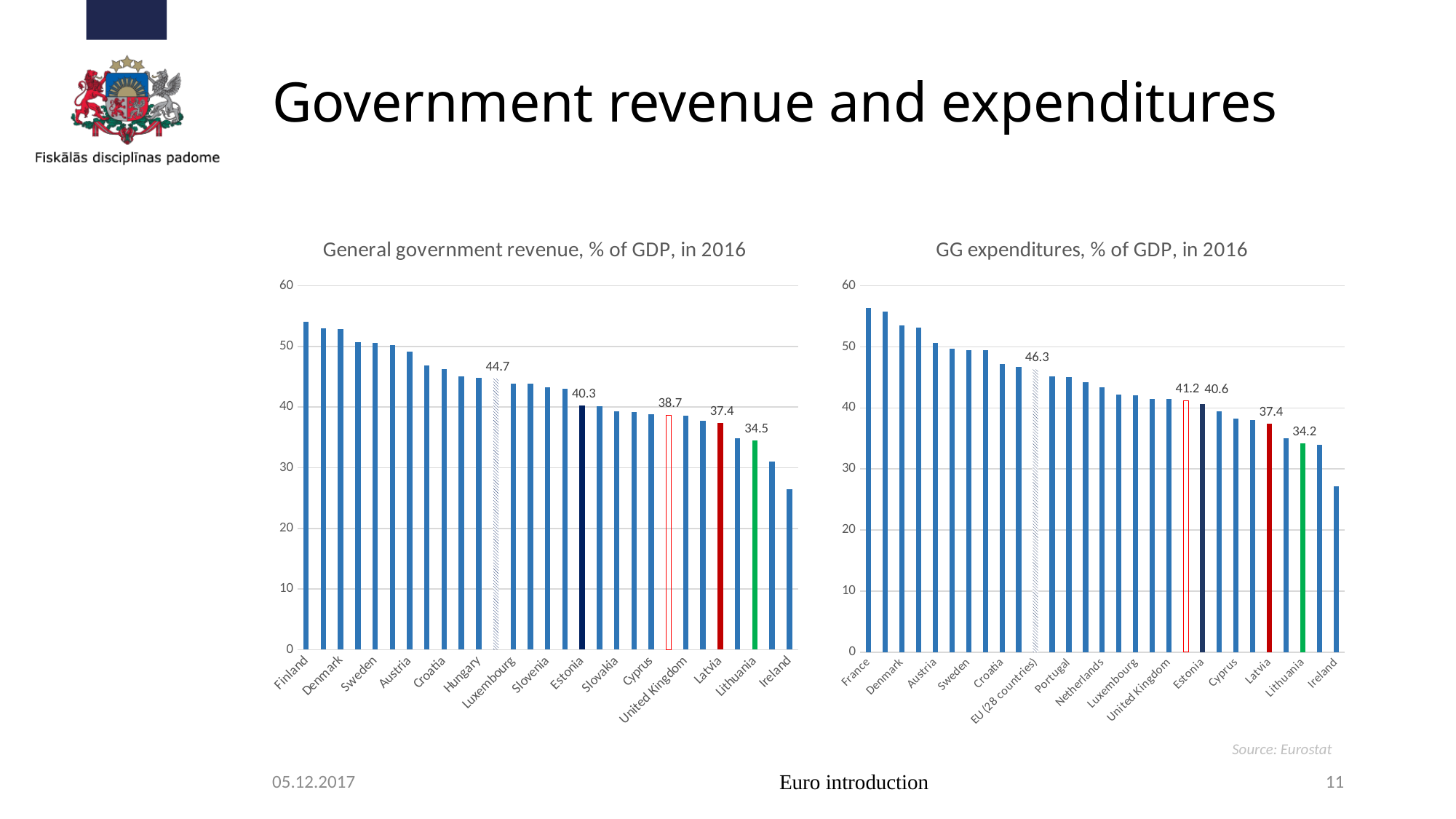
In the 'GG expenditures, % of GDP, in 2016' chart, what is the value for Lithuania? 34.2 In the 'General government revenue, % of GDP, in 2016' chart, which is larger, the value for Estonia or the value for Lithuania? Estonia In the 'General government revenue, % of GDP, in 2016' chart, what is the value for Latvia? 37.4 In the 'GG expenditures, % of GDP, in 2016' chart, what is the value for EU (28 countries)? 46.3 In the 'GG expenditures, % of GDP, in 2016' chart, is the value for France greater or less than 50? greater In the 'GG expenditures, % of GDP, in 2016' chart, what is the difference between the values for Estonia and Latvia? 3.2 In the 'General government revenue, % of GDP, in 2016' chart, what is the value for Lithuania? 34.5 What kind of chart is the 'General government revenue, % of GDP, in 2016' chart? bar chart In the 'General government revenue, % of GDP, in 2016' chart, what is the value for Estonia? 40.3 In the 'General government revenue, % of GDP, in 2016' chart, which country has the highest value? Finland In the 'GG expenditures, % of GDP, in 2016' chart, do the values rise or fall from left to right along the x axis? fall In the 'GG expenditures, % of GDP, in 2016' chart, which country has the lowest value? Ireland